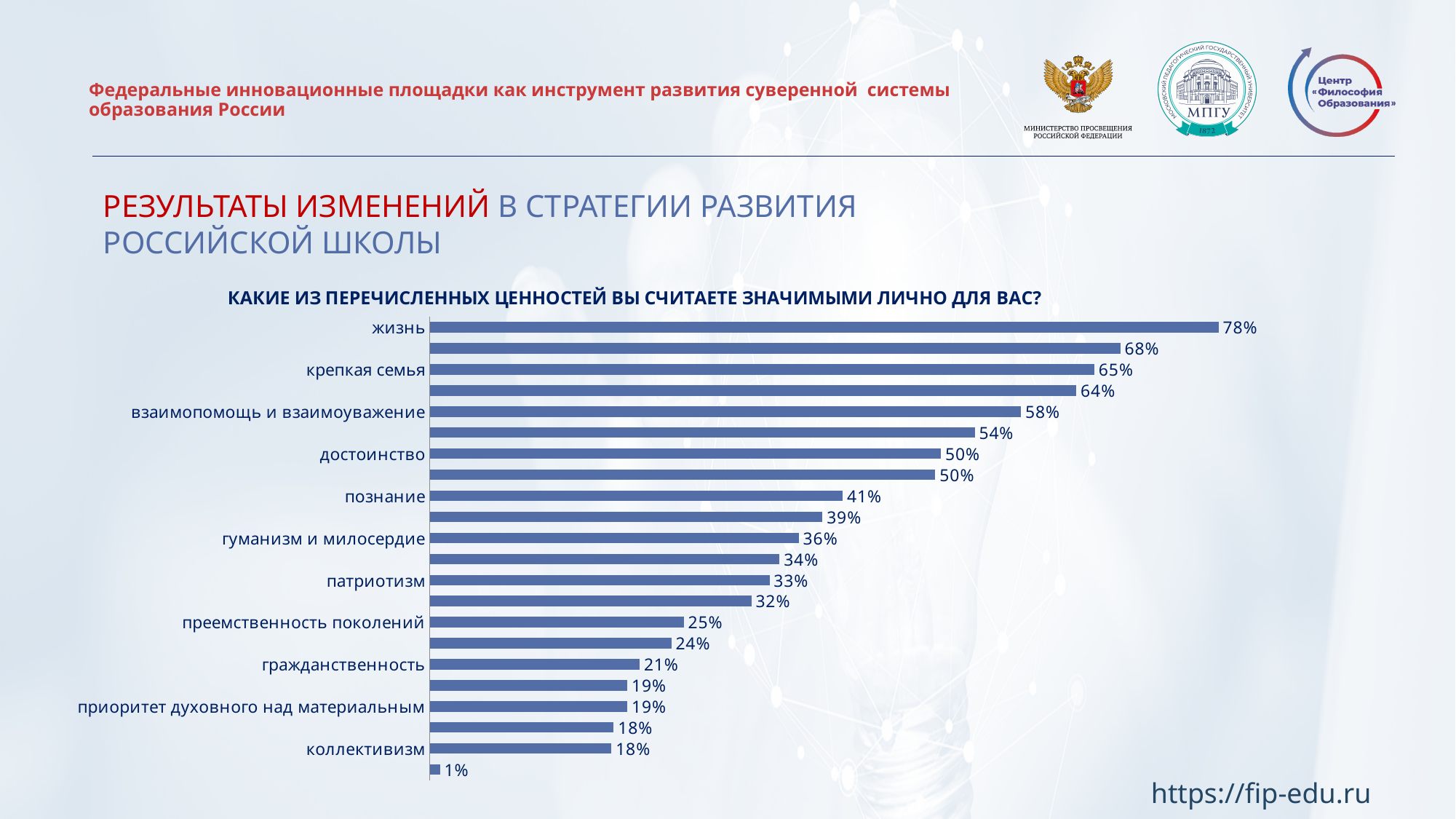
What percentage is shown for коллективизм? 18% What is the difference between the values for жизнь and достоинство? 28% Do the values increase or decrease going from the top bar to the bottom bar? decrease What percentage is shown for крепкая семья? 65% Which labeled category has the highest value? жизнь What question is the chart titled with? КАКИЕ ИЗ ПЕРЕЧИСЛЕННЫХ ЦЕННОСТЕЙ ВЫ СЧИТАЕТЕ ЗНАЧИМЫМИ ЛИЧНО ДЛЯ ВАС? What percentage is shown for жизнь? 78% What percentage is shown for патриотизм? 33% What kind of chart is shown on the slide? bar chart How many bars are plotted on the chart? 22 What is the smallest value shown on the chart? 1% Which is larger, the value for познание or the value for гуманизм и милосердие? познание